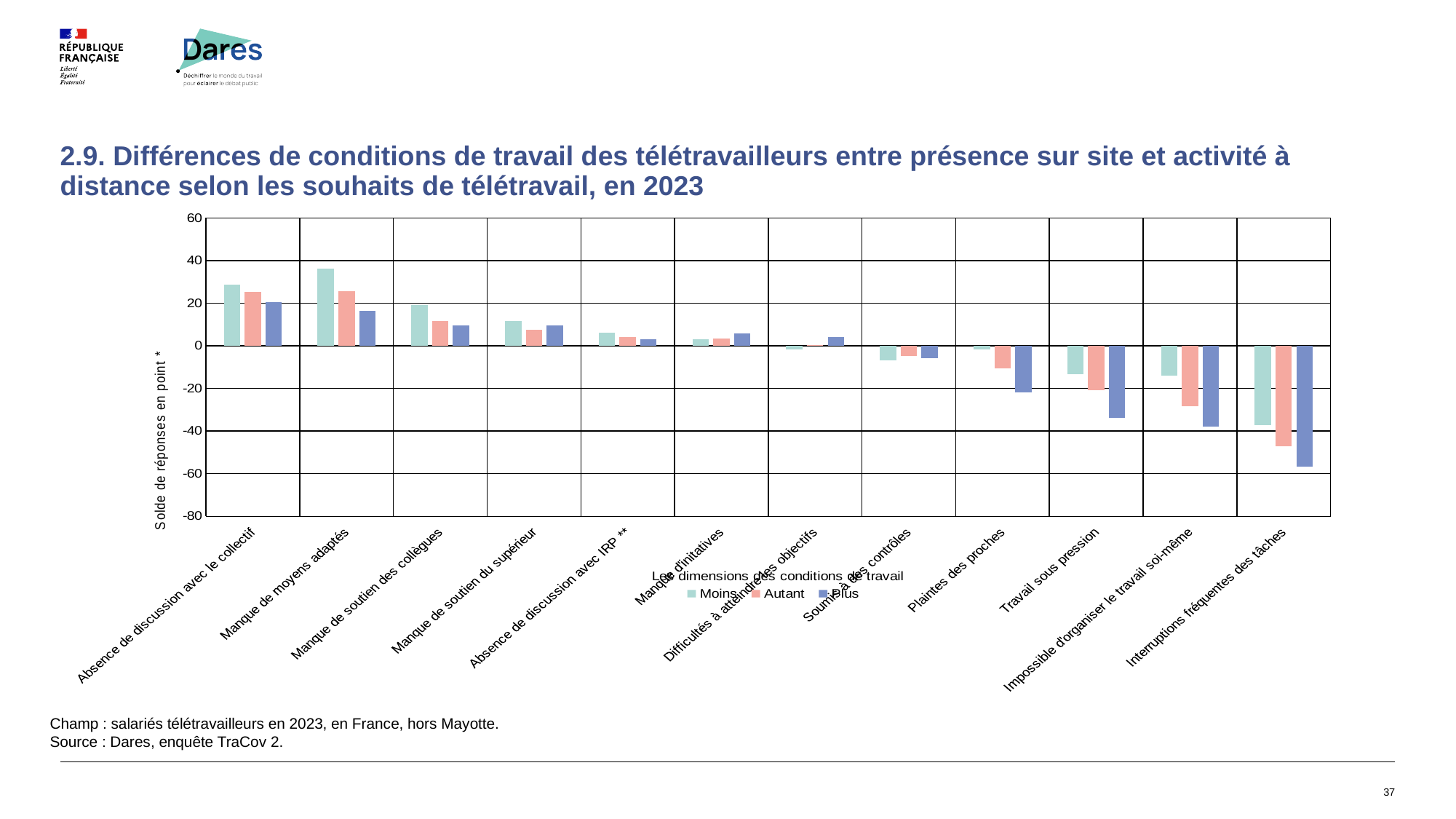
Is the 'Moins' value for 'Manque de moyens adaptés' greater or less than 20? greater For the 'Plus' series, which is larger: the value for 'Plaintes des proches' or the value for 'Travail sous pression'? Plaintes des proches What are the three legend entries of the chart? Moins, Autant, Plus What kind of chart is shown on the slide? bar chart Is the 'Plus' value for 'Interruptions fréquentes des tâches' greater or less than -40? less Which category has the lowest value for the 'Plus' series? Interruptions fréquentes des tâches What is the label of the vertical axis? Solde de réponses en point * How many series does the legend list? 3 Which category has the highest value for the 'Moins' series? Manque de moyens adaptés Is the 'Autant' value for 'Impossible d'organiser le travail soi-même' greater or less than -20? less How many categories are shown on the x axis? 12 Do the 'Plus' values generally rise or fall across the categories from left to right? fall